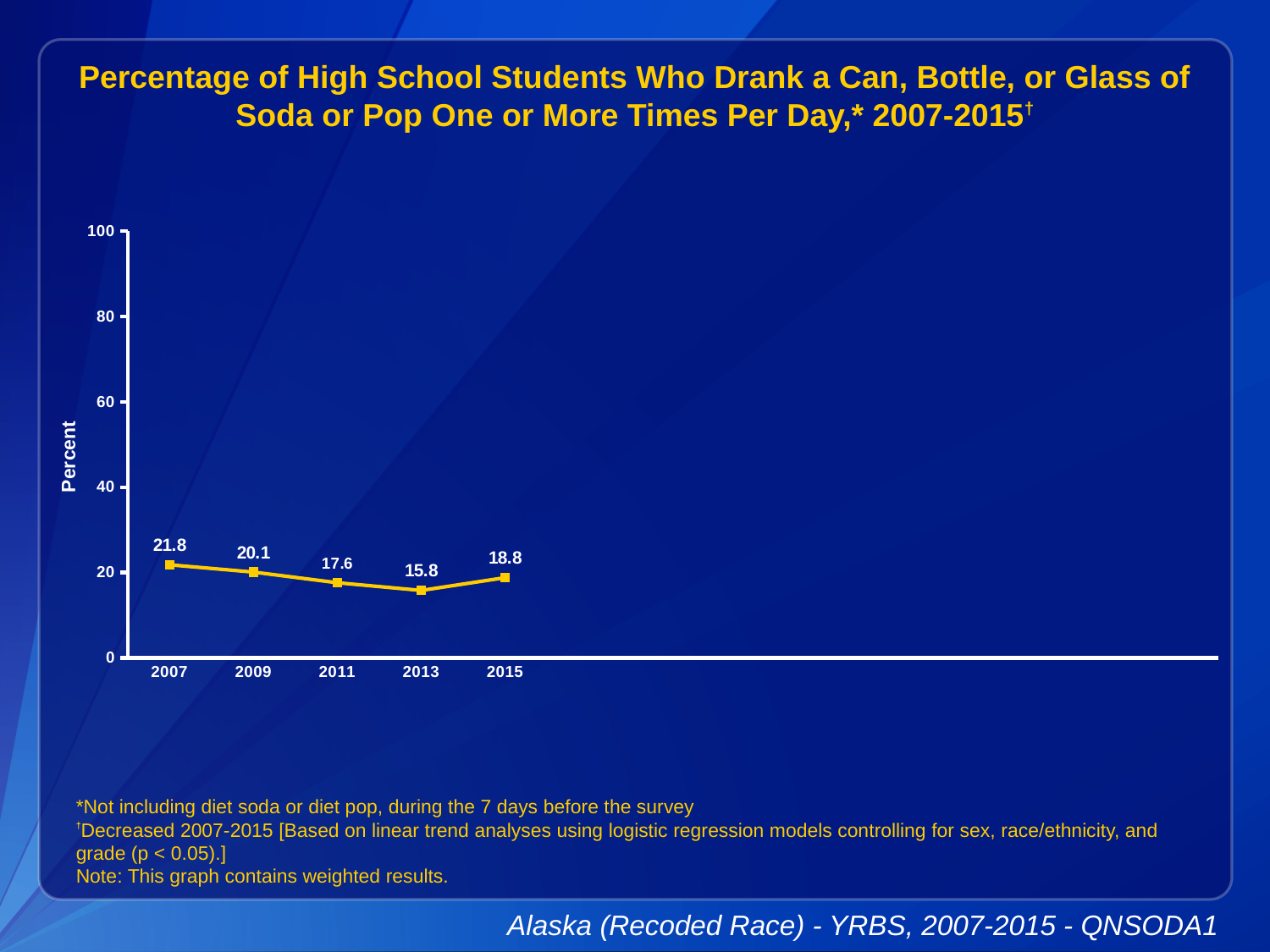
What is the value plotted for 2015? 18.8 What percentage of high school students drank soda or pop one or more times per day in 2007? 21.8 How many years are plotted on the chart? 5 Which is larger, the value for 2009 or the value for 2011? 2009 What is the difference between the 2007 value and the 2013 value? 6.0 What is the value plotted for 2013? 15.8 Do the values rise or fall from 2007 to 2013? fall What kind of chart is shown on the slide? line chart Is the value for 2011 greater or less than 20? less Which year has the lowest percentage? 2013 What is the label on the y axis? Percent Which year has the highest percentage? 2007